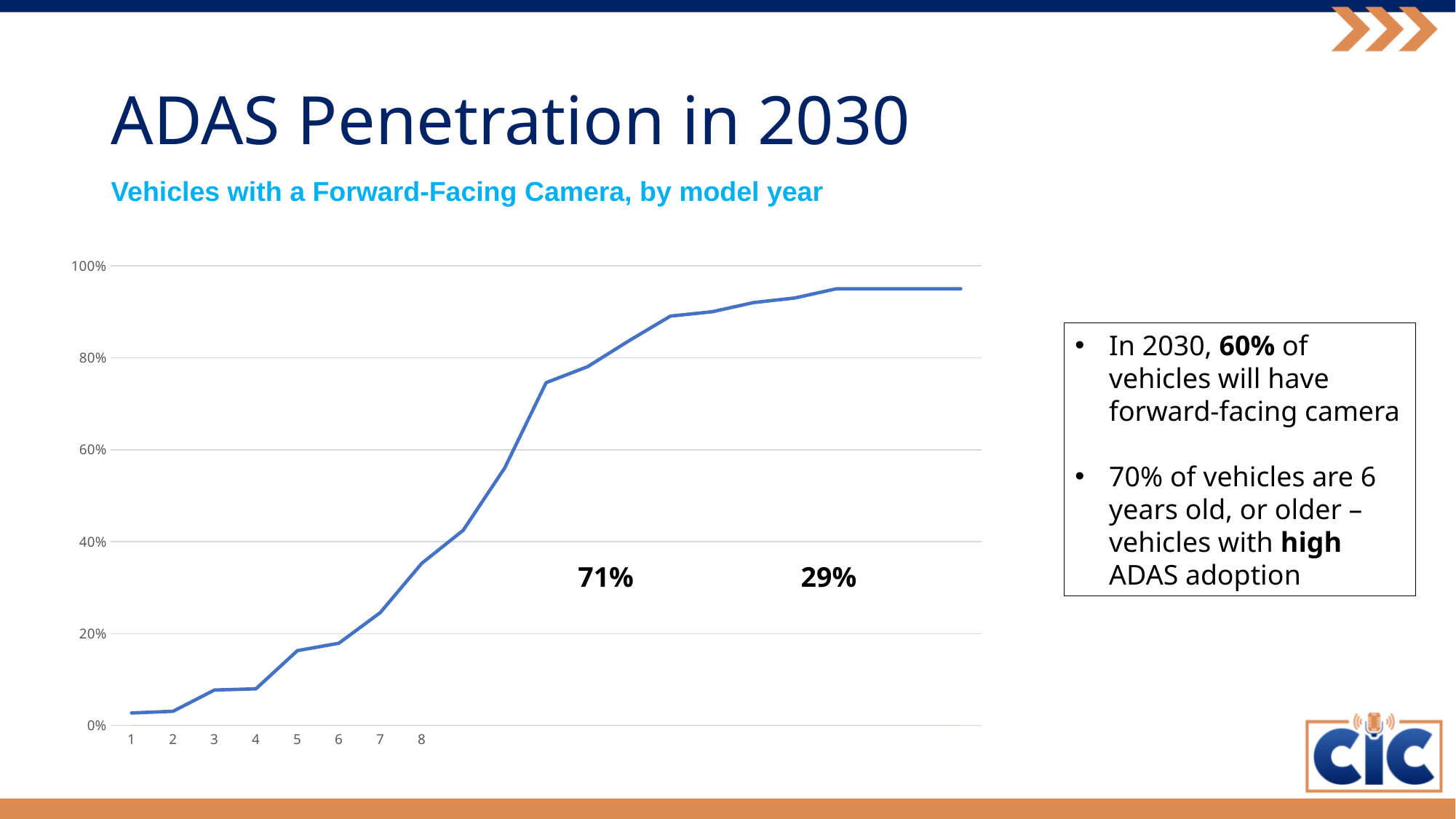
Do the values in the chart rise or fall as the model year increases along the x axis? rise Is the value for model year 5 greater or less than 40%? less Is the value for model year 1 greater or less than 20%? less Is the value for model year 7 greater or less than 20%? greater Which has the larger value, model year 1 or model year 8? model year 8 Which has the larger value, model year 4 or model year 7? model year 7 What is the highest value shown on the y axis of the chart? 100% What is the title of the chart? Vehicles with a Forward-Facing Camera, by model year What kind of chart is shown on the slide? line chart